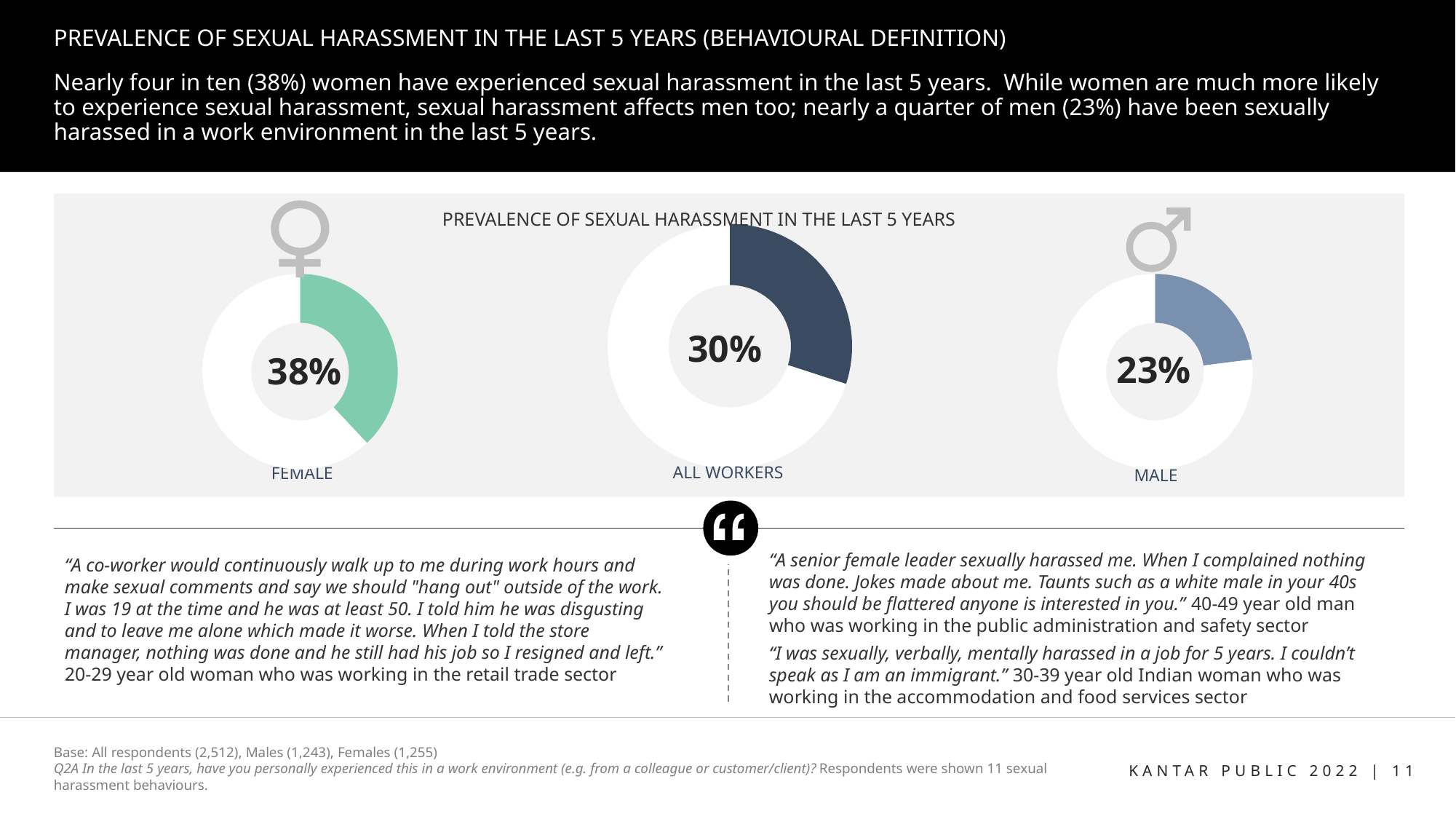
Which is larger: the value in the All Workers chart or the value in the Male chart? All Workers What is the difference in percentage points between the Female chart value and the Male chart value? 15 Across the three donut charts (Female, All Workers, Male), which group has the lowest prevalence? Male What is the title shown above the three donut charts? PREVALENCE OF SEXUAL HARASSMENT IN THE LAST 5 YEARS What is the difference in percentage points between the Female chart value and the All Workers chart value? 8 In the Female donut chart, what percentage of women have experienced sexual harassment in the last 5 years? 38% In the Male donut chart, what percentage of men have experienced sexual harassment in the last 5 years? 23% In the All Workers donut chart, what percentage is shown? 30% What colour is the filled segment of the Female donut chart? Green How many donut charts are shown on the slide? 3 Across the three donut charts (Female, All Workers, Male), which group has the highest prevalence? Female What kind of chart is used to show the prevalence for Female, All Workers and Male? Donut chart